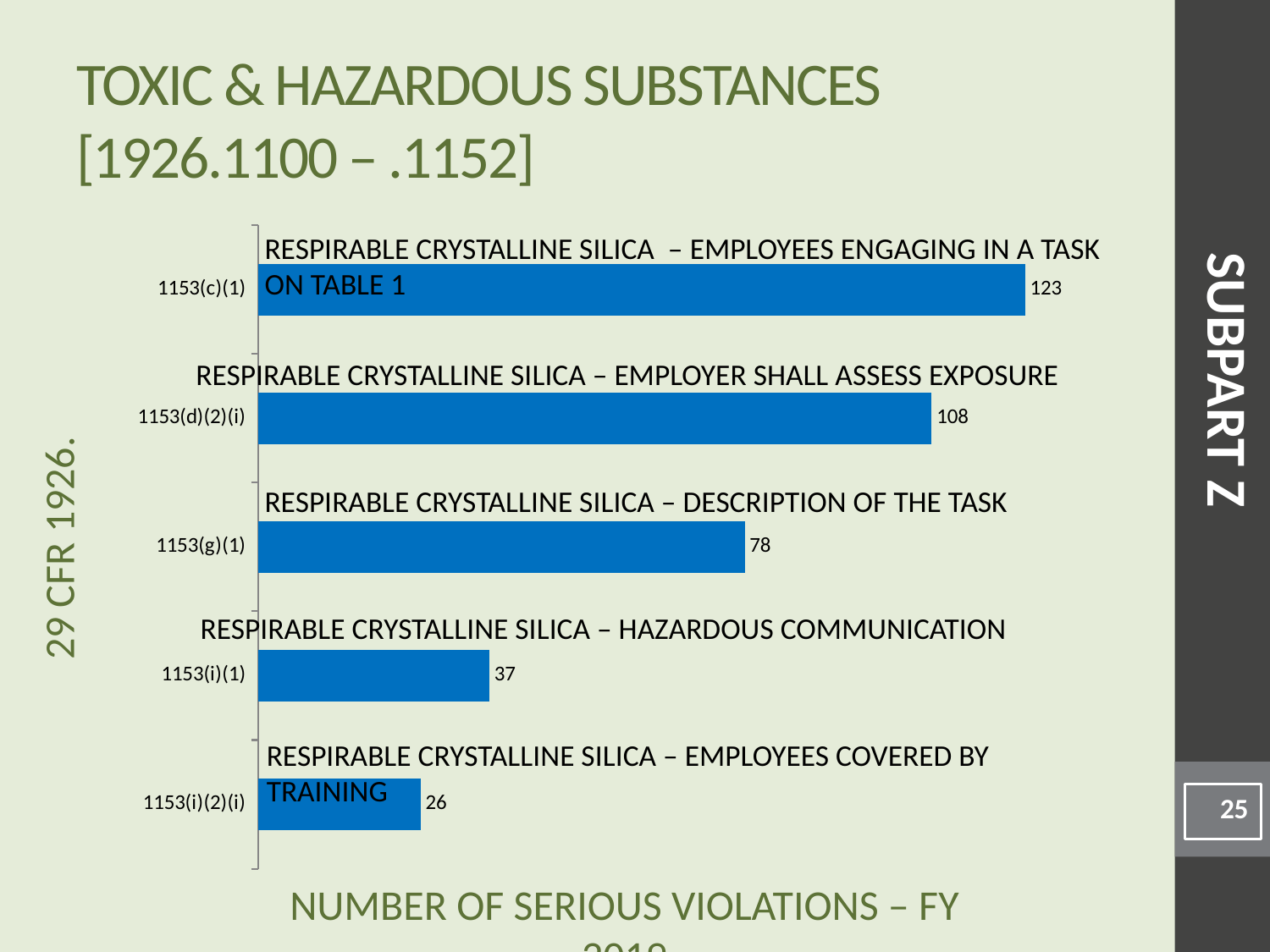
What is the number of serious violations for 1153(g)(1)? 78 What is the number of serious violations for 1153(c)(1)? 123 What is the number of serious violations for 1153(i)(1)? 37 What is the difference in serious violations between 1153(c)(1) and 1153(d)(2)(i)? 15 Which category has the highest number of serious violations? 1153(c)(1) What is the difference in serious violations between 1153(g)(1) and 1153(i)(1)? 41 How many categories are shown in the chart? 5 What kind of chart is shown on the slide? Bar chart Which category has the lowest number of serious violations? 1153(i)(2)(i) What is the number of serious violations for 1153(i)(2)(i)? 26 What is the number of serious violations for 1153(d)(2)(i)? 108 Which has more serious violations, 1153(i)(1) or 1153(i)(2)(i)? 1153(i)(1)